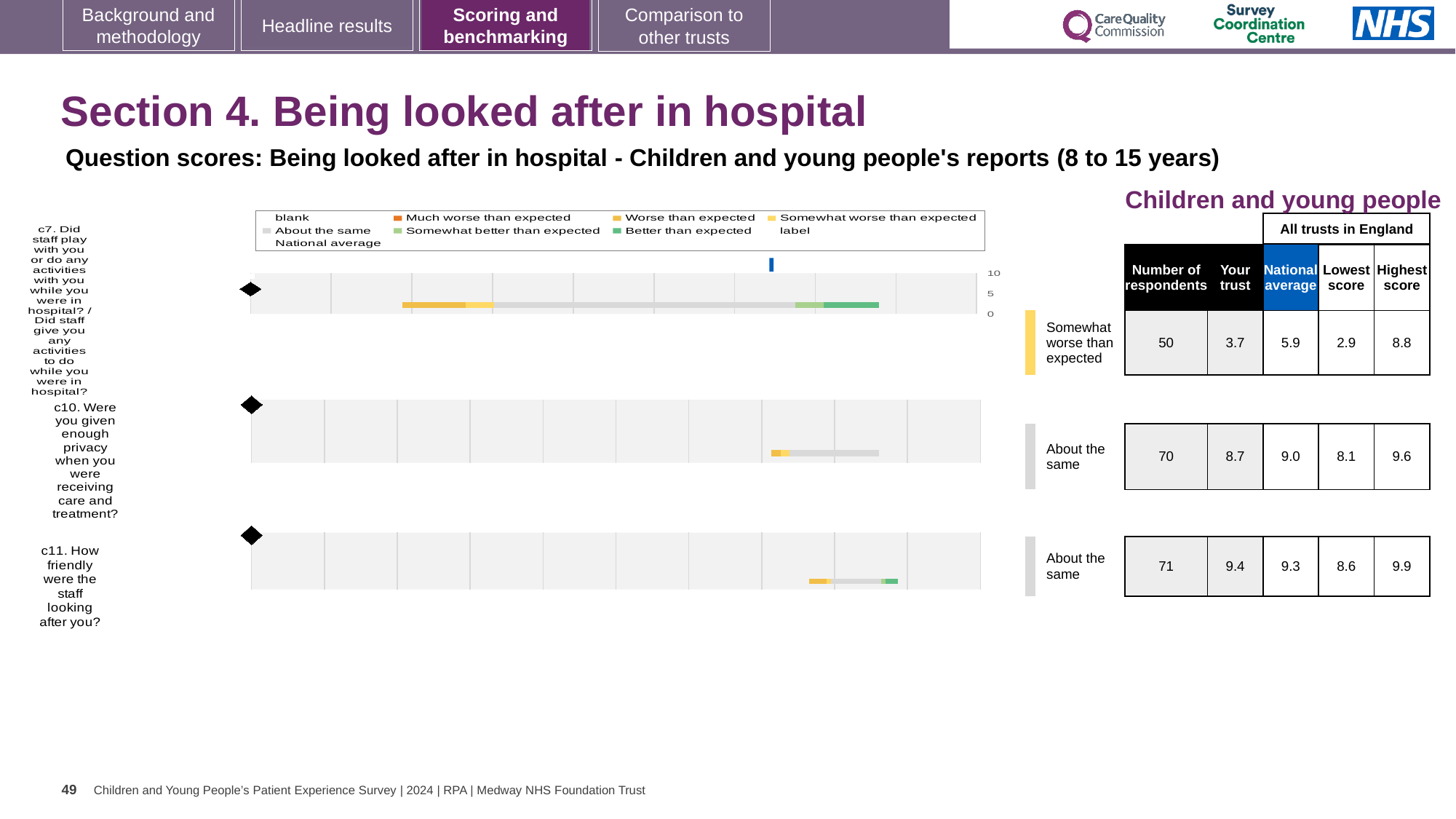
What is the highest score across all trusts in England for question c11 (How friendly were the staff looking after you?)? 9.9 What is the national average score for question c10 (Were you given enough privacy when you were receiving care and treatment?)? 9.0 How many questions (c7, c10, c11) have a benchmark bar chart on this slide? 3 Which question has the highest 'Your trust' score on this slide? c11 How many respondents answered question c10? 70 What kind of chart is used to show the question scores on this slide? bar chart What benchmark category label is shown for question c7? Somewhat worse than expected For question c11, is the 'Your trust' score or the national average score larger? Your trust What benchmark category label is shown for question c11? About the same What is the difference between the national average and the 'Your trust' score for question c7? 2.2 Which question has the lowest 'Your trust' score on this slide? c7 What is the 'Your trust' score for question c7 (Did staff play with you or do any activities with you while you were in hospital?)? 3.7